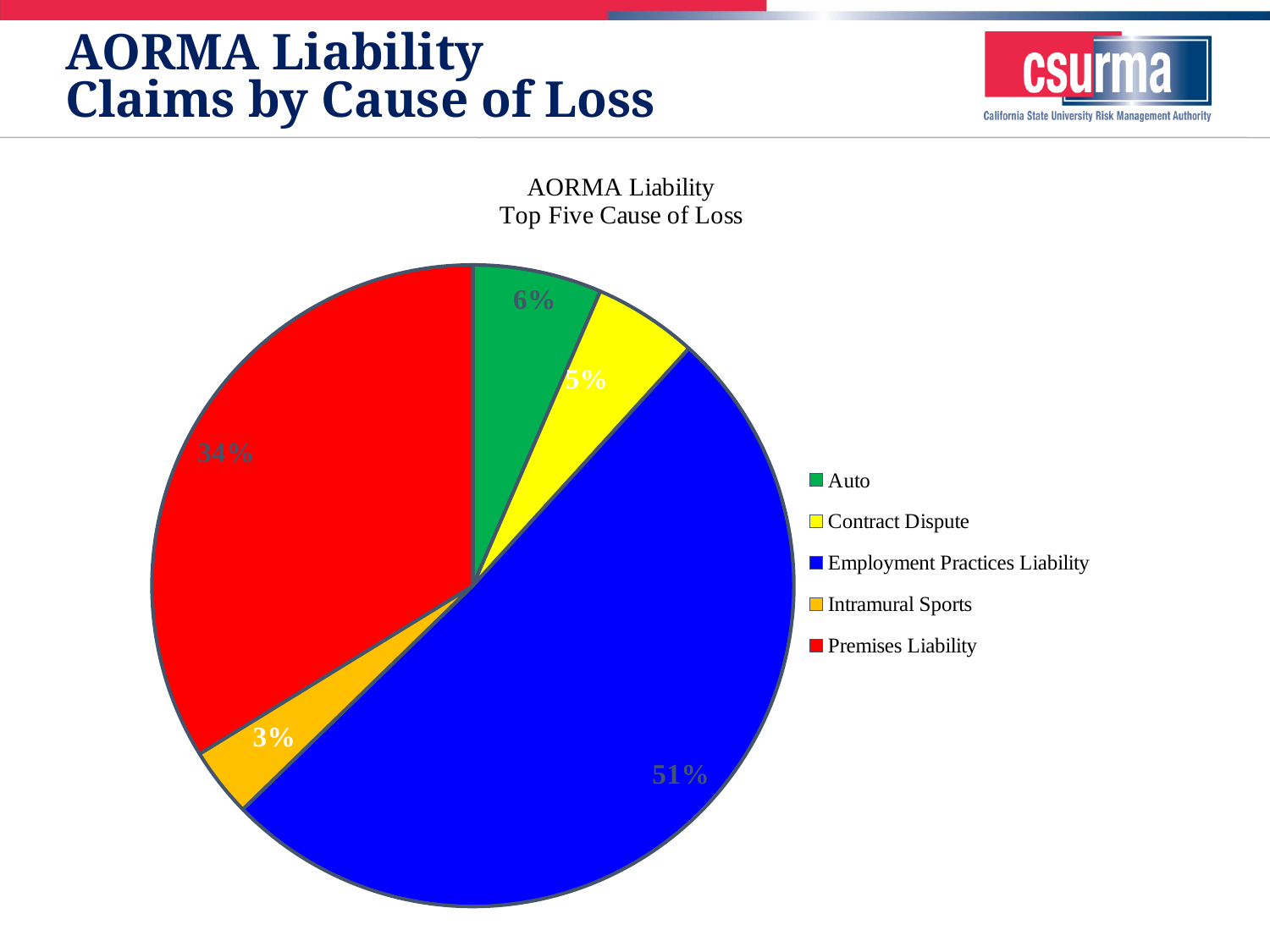
How many categories does the legend list? 5 What type of chart is shown on the slide? Pie chart What is the title of the chart? AORMA Liability Top Five Cause of Loss What is the difference in percentage points between Employment Practices Liability and Premises Liability? 17 What is the value shown for Contract Dispute? 5% Which cause of loss has the largest share of the pie? Employment Practices Liability What share of the pie does Employment Practices Liability represent? 51% What is the value shown for Auto? 6% Which cause of loss has the smallest share of the pie? Intramural Sports What is the value shown for Intramural Sports? 3% Which is larger, the share for Auto or the share for Intramural Sports? Auto What share of the pie does Premises Liability represent? 34%